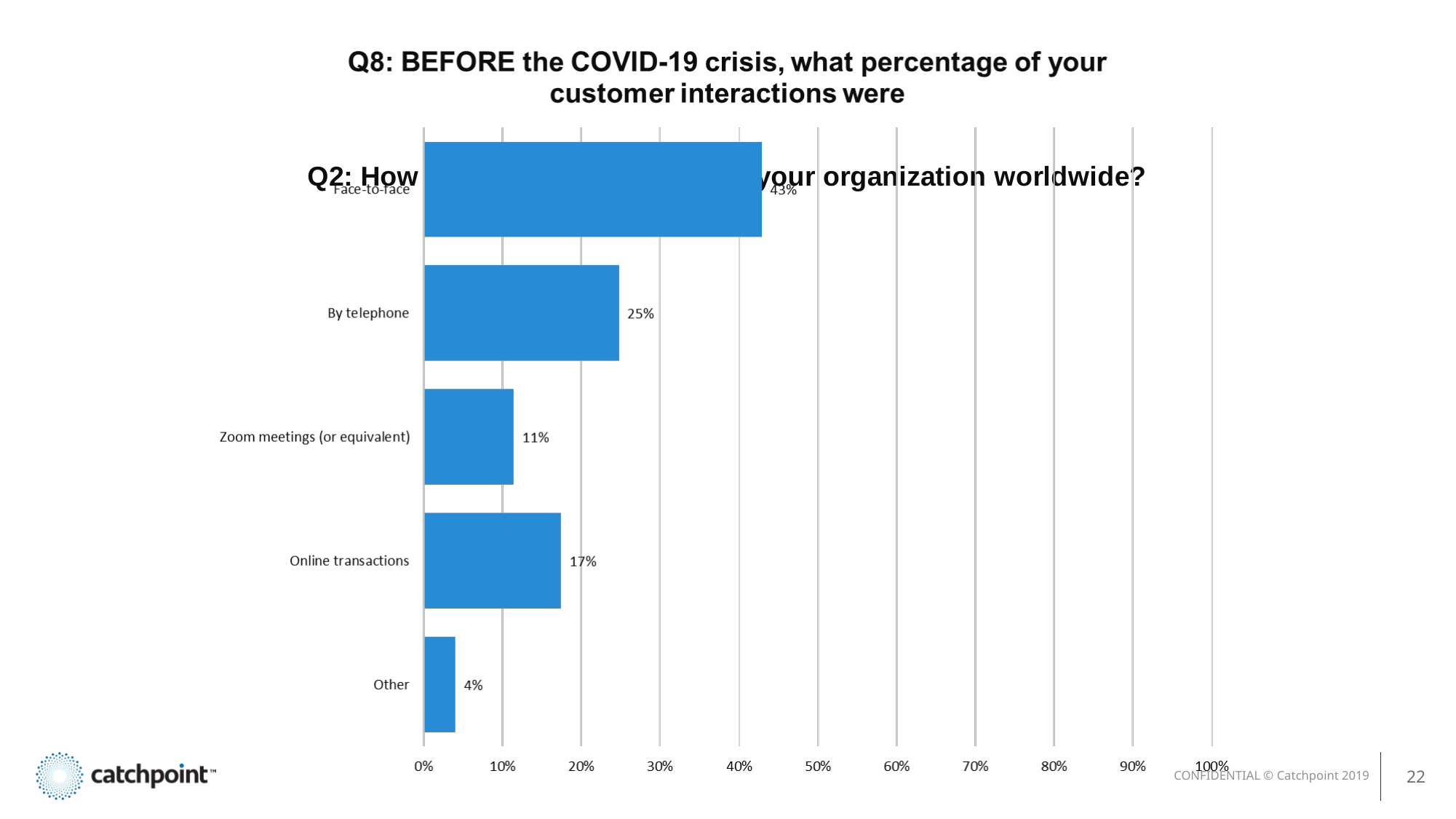
What percentage of customer interactions were face-to-face before the COVID-19 crisis? 43% How many categories are shown in the chart? 5 What is the value shown for 'Zoom meetings (or equivalent)'? 11% What is the value shown for 'By telephone'? 25% What is the value shown for 'Other'? 4% What is the value shown for 'Online transactions'? 17% Which category has the lowest value? Other What kind of chart is shown on the slide? Bar chart Which category has the highest value? Face-to-face What is the highest value shown on the x axis? 100% Which is larger, Online transactions or Zoom meetings (or equivalent)? Online transactions What is the difference between the Face-to-face and By telephone values? 18%